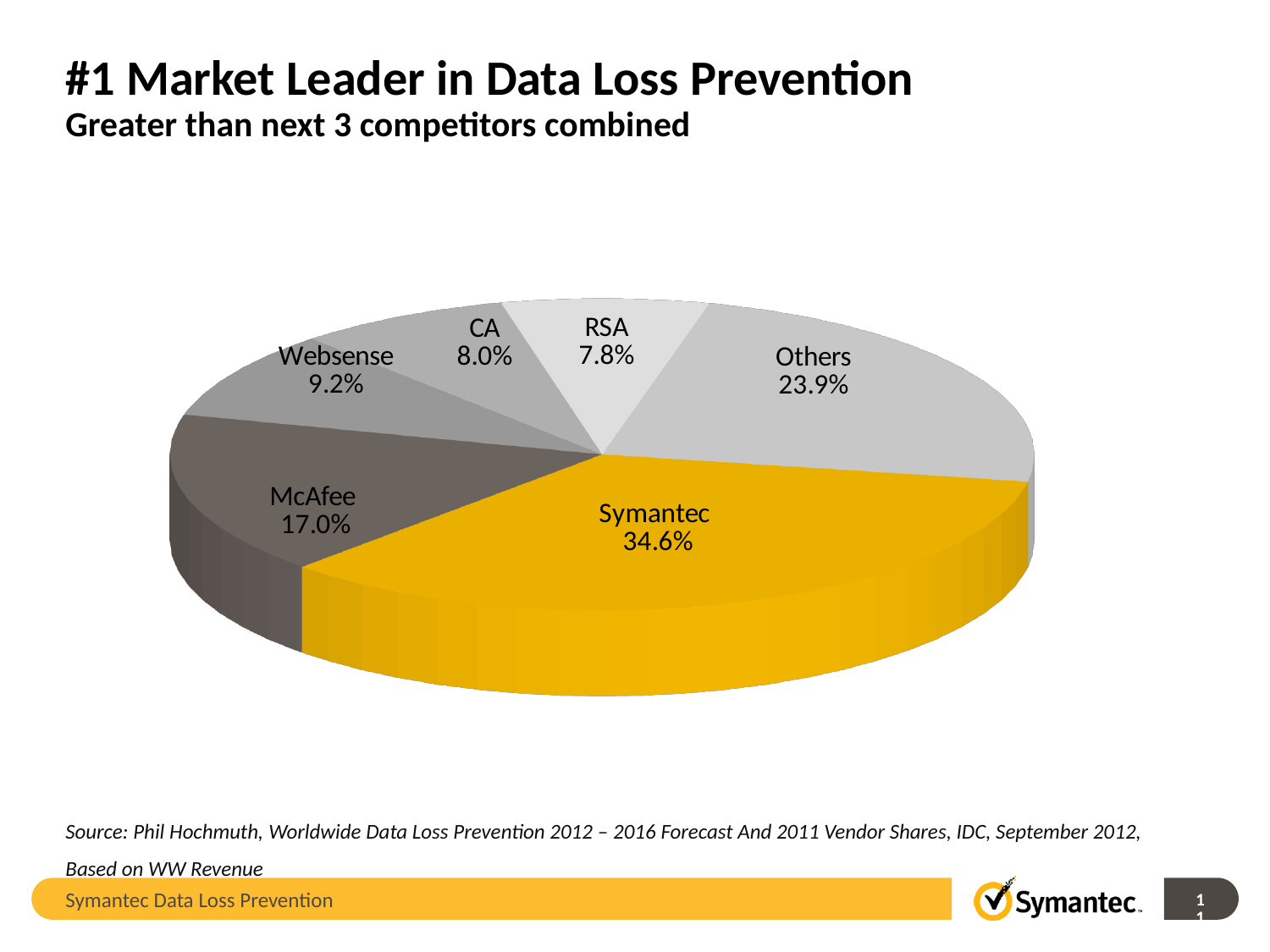
How much larger is the Others slice than the McAfee slice? 6.9% What type of chart is shown on the slide? Pie chart What is the value labelled for Websense? 9.2% Which vendor has the largest slice of the pie? Symantec How many slices does the pie chart have? 6 What percentage is shown for McAfee? 17.0% Which is larger, Websense or McAfee? McAfee What is the combined share of McAfee, Websense and CA? 34.2% Which named slice has the smallest share? RSA What is the difference between Symantec's share and McAfee's share? 17.6% Which is larger, the CA slice or the RSA slice? CA What share of the pie does Symantec hold? 34.6%